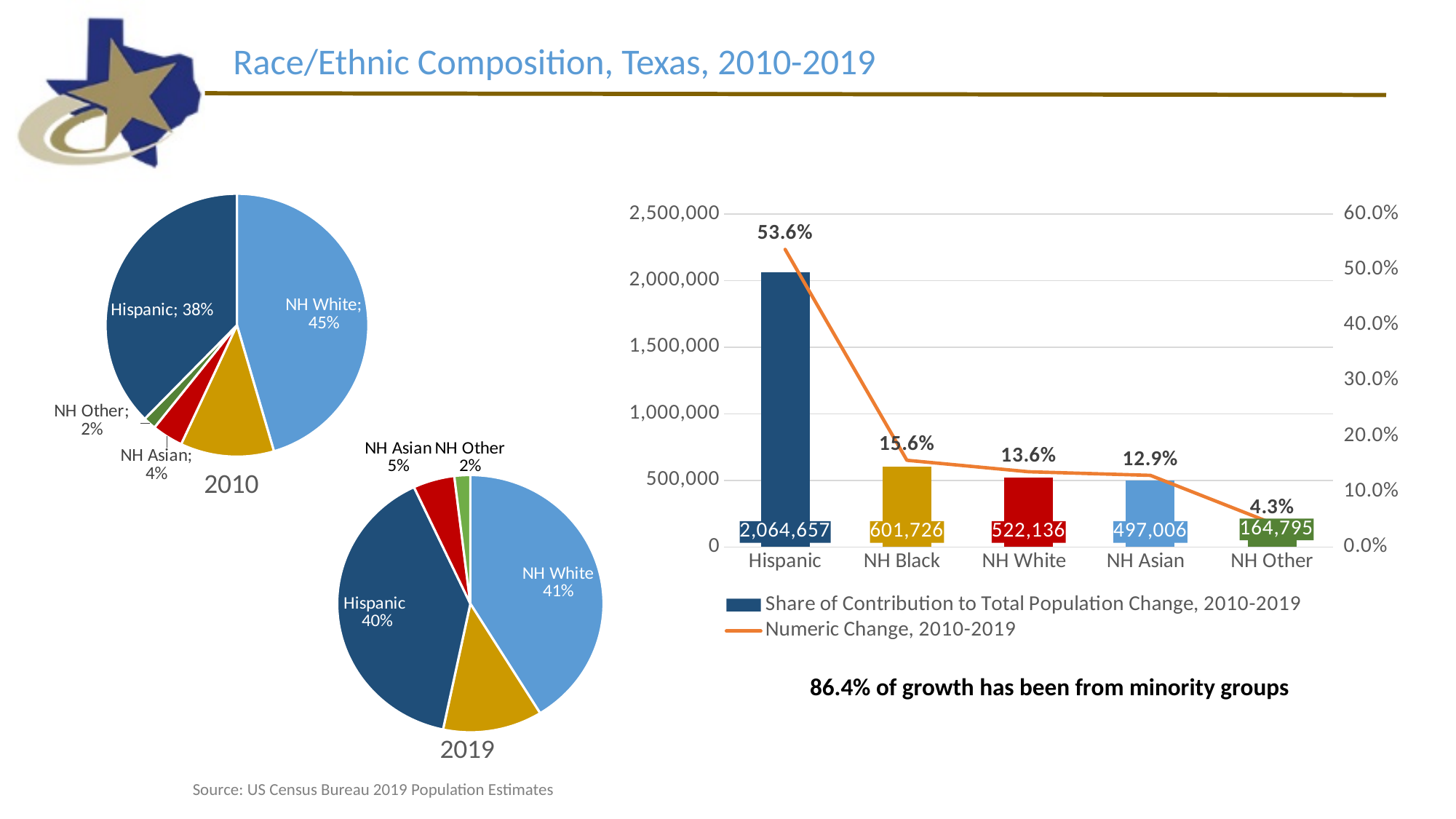
In the bar chart on the right, what is the value of the bar for NH Other? 164,795 In the bar chart on the right, which category has the highest bar? Hispanic In the 2019 pie chart, what is the difference between the NH White and Hispanic shares? 1% In the 2010 pie chart, what share is NH White? 45% In the 2019 pie chart, which is larger, NH White or Hispanic? NH White In the chart on the right, what percentage is labelled on the line for NH Asian? 12.9% In the chart on the right, how many categories are shown on the x axis? 5 In the bar chart on the right, what is the difference between the bars for NH Black and NH White? 79,590 In the bar chart on the right, which category has the lowest bar? NH Other In the bar chart on the right, what is the value of the bar for Hispanic? 2,064,657 In the 2010 pie chart, what share is Hispanic? 38% In the 2019 pie chart, what share is NH Asian? 5%